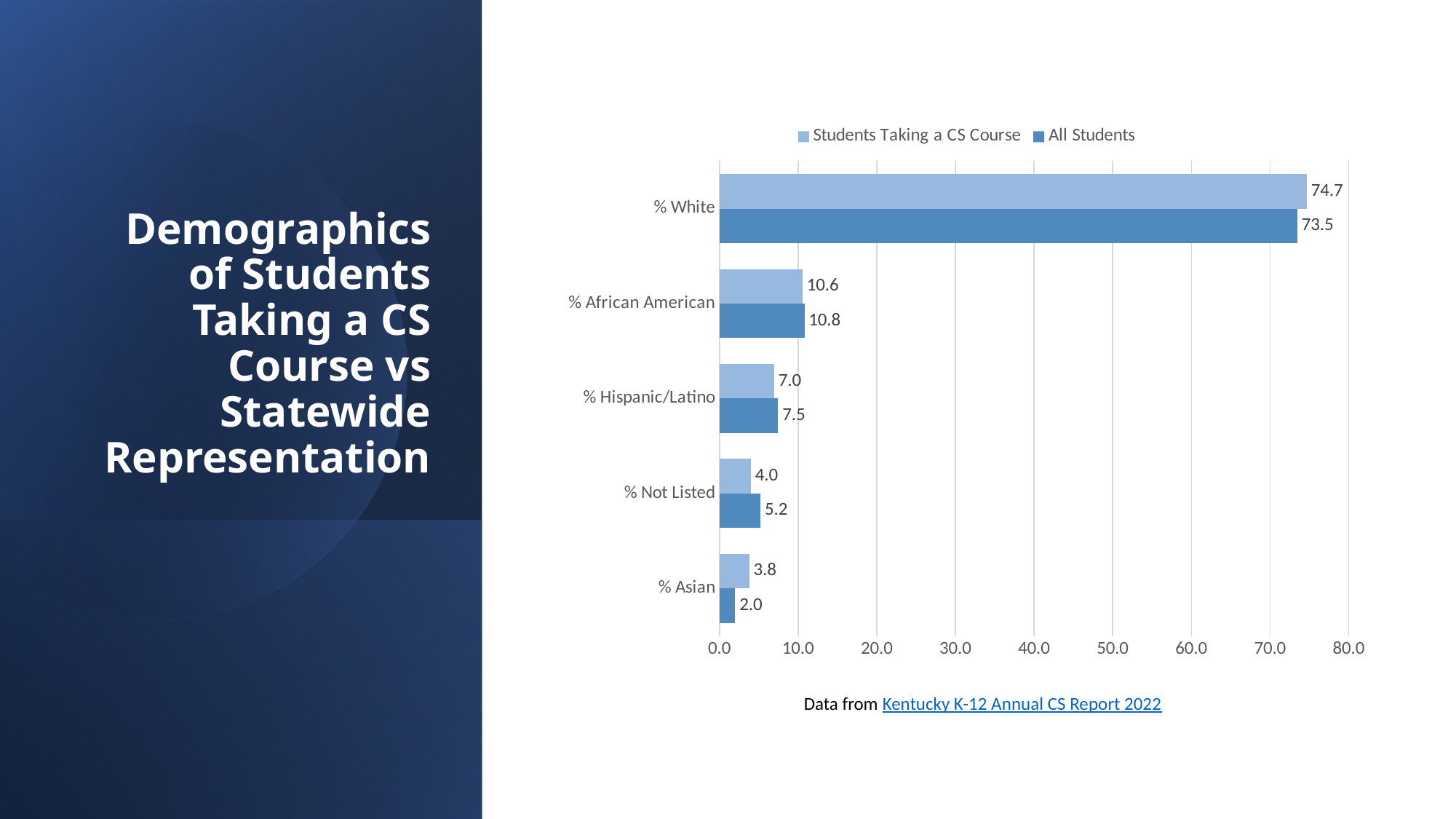
What is the value for % Not Listed in the All Students series? 5.2 What is the value for % White in the Students Taking a CS Course series? 74.7 How many categories are shown on the chart? 5 Is the All Students value for % White greater or less than 70.0? greater What is the value for % Asian in the All Students series? 2.0 What is the difference between the Students Taking a CS Course and All Students values for % White? 1.2 How many series does the legend list? 2 For % Asian, which series has the larger value: Students Taking a CS Course or All Students? Students Taking a CS Course What kind of chart is shown on the slide? Bar chart Which category has the lowest value in the Students Taking a CS Course series? % Asian What is the difference between the All Students and Students Taking a CS Course values for % Not Listed? 1.2 Which category has the highest value in the All Students series? % White